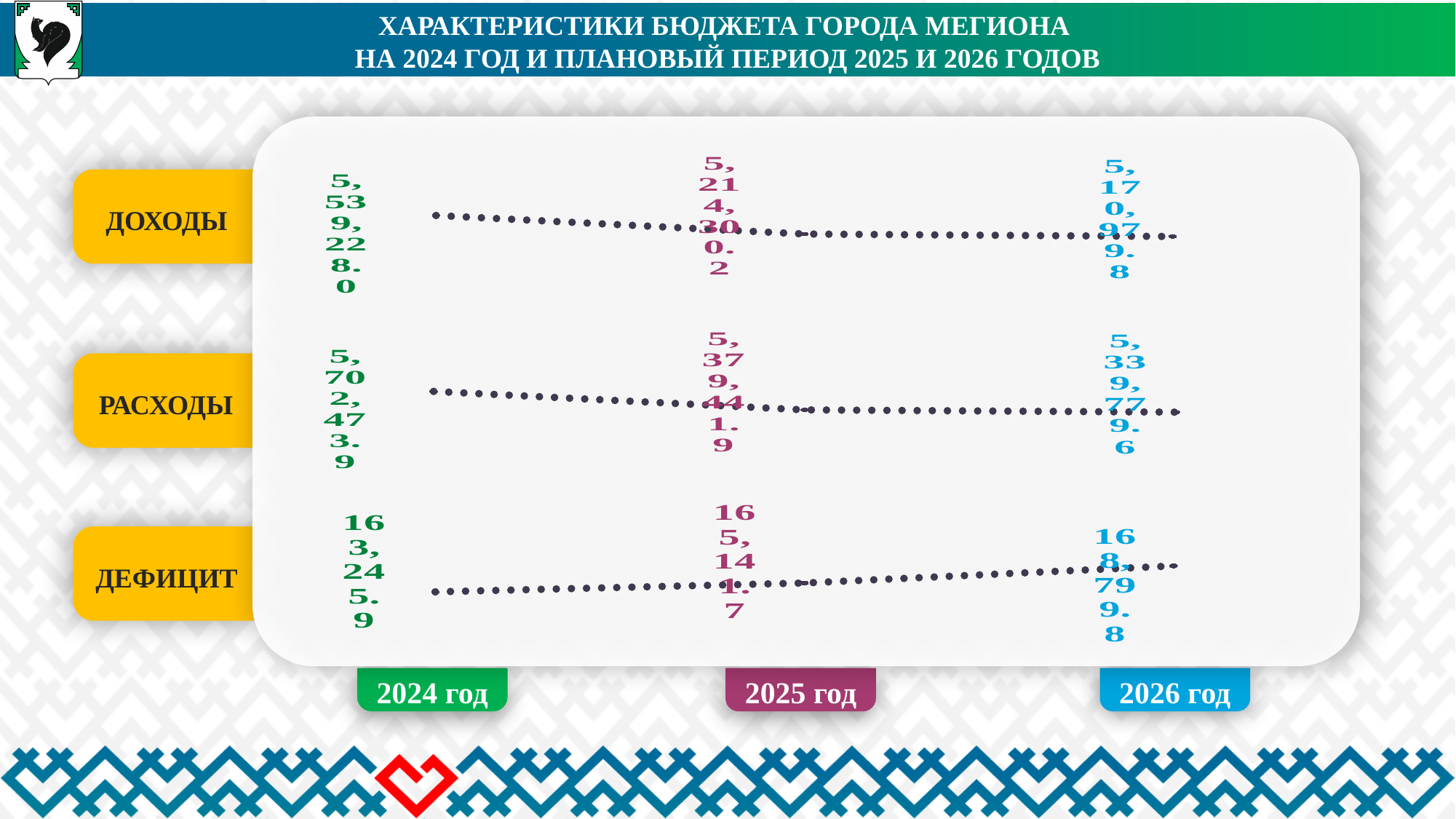
Which is larger in 2025 год, ДОХОДЫ or РАСХОДЫ? РАСХОДЫ What is the value for ДОХОДЫ in 2026 год? 5,170,979.8 What is the value for РАСХОДЫ in 2025 год? 5,379,441.9 What is the value for ДОХОДЫ in 2024 год? 5,539,228.0 Do the values for ДОХОДЫ rise or fall from 2024 год to 2026 год? fall What is the value for ДЕФИЦИТ in 2026 год? 168,799.8 What is the difference between РАСХОДЫ and ДОХОДЫ in 2024 год? 163,245.9 In which year is ДЕФИЦИТ highest? 2026 год What is the value for РАСХОДЫ in 2024 год? 5,702,473.9 How many years are shown on the x axis? 3 Do the values for ДЕФИЦИТ rise or fall from 2024 год to 2026 год? rise In which year is ДОХОДЫ lowest? 2026 год